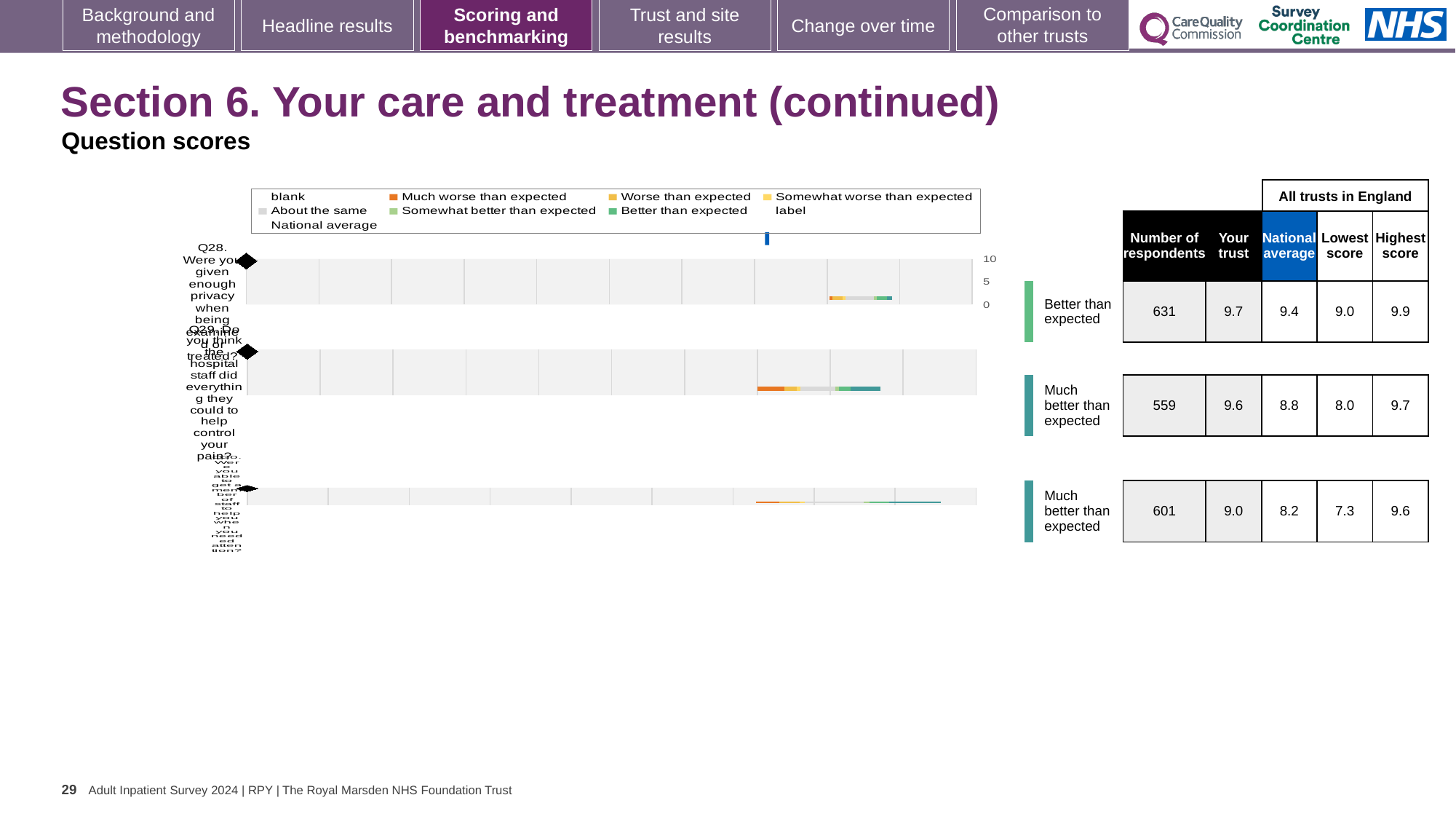
What is the difference between the trust score and the national average for Q30? 0.8 Which of the three questions has the lowest 'Your trust' score? Q30 How many respondents answered Q30 (able to get a member of staff to help when needed)? 601 What is the national average score for Q29 (staff did everything to help control pain)? 8.8 What is the lowest score among all trusts in England for Q30? 7.3 Which of the three questions has the highest national average score? Q28 What kind of chart is used to show the question scores on this slide? bar chart Is the trust score for Q29 higher or lower than the national average for Q29? higher What is the 'Your trust' score for Q28 (privacy when being examined or treated)? 9.7 Which legend entry is shown in orange? Much worse than expected How many questions (categories) are plotted in the chart? 3 What is the highest value shown on the chart's numeric axis? 10